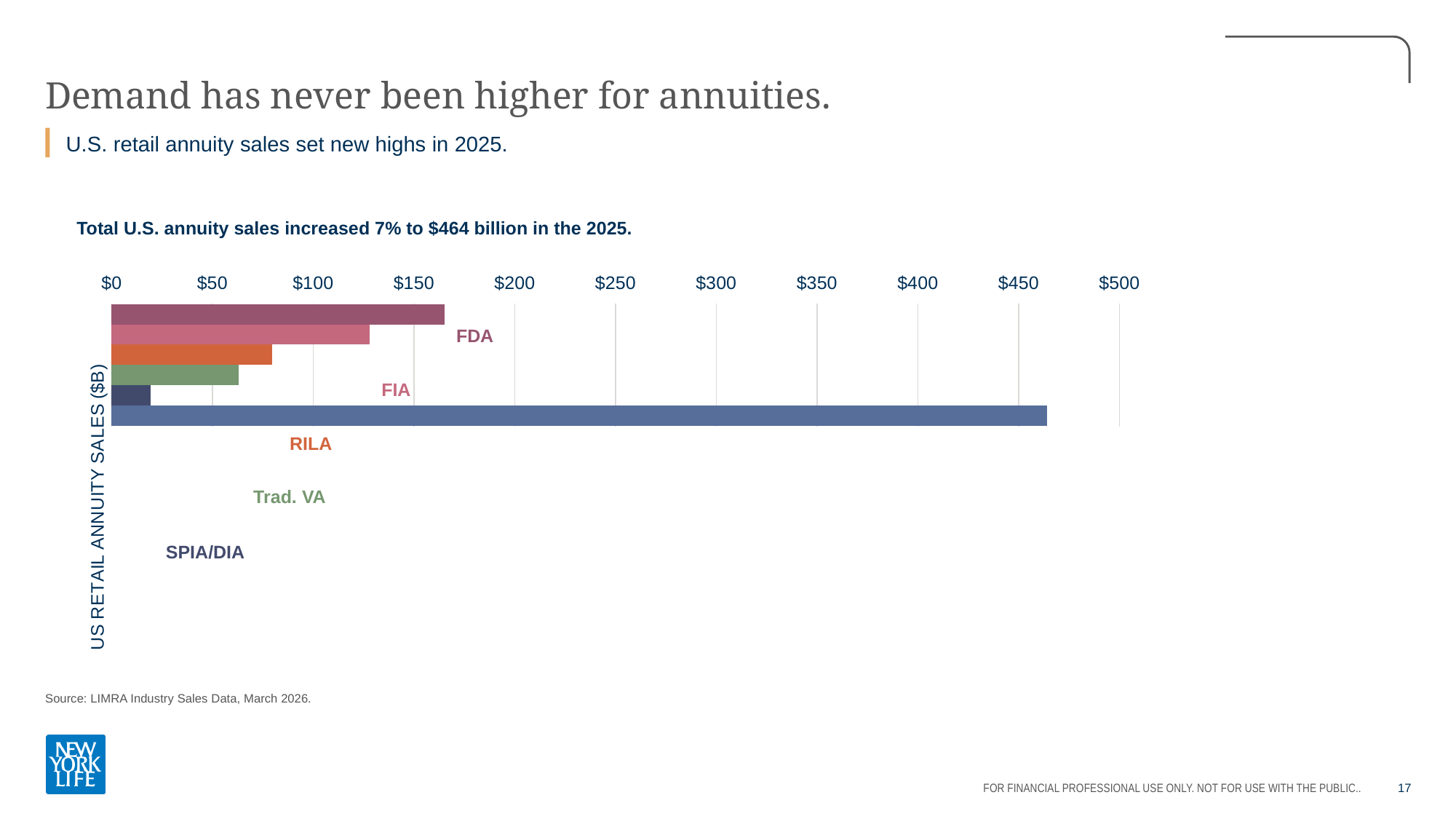
How many labeled product categories are shown in the chart? 5 What is the label on the vertical axis of the chart? US RETAIL ANNUITY SALES ($B) Is the value for FDA greater or less than $150? greater Is the value for Trad. VA greater or less than $50? greater Is the value for FIA greater or less than $150? less Which is larger, the value for RILA or the value for Trad. VA? RILA Among the labeled product categories (FDA, FIA, RILA, Trad. VA, SPIA/DIA), which has the highest sales? FDA What kind of chart is shown on the slide? bar chart Among the labeled product categories, which has the lowest sales? SPIA/DIA